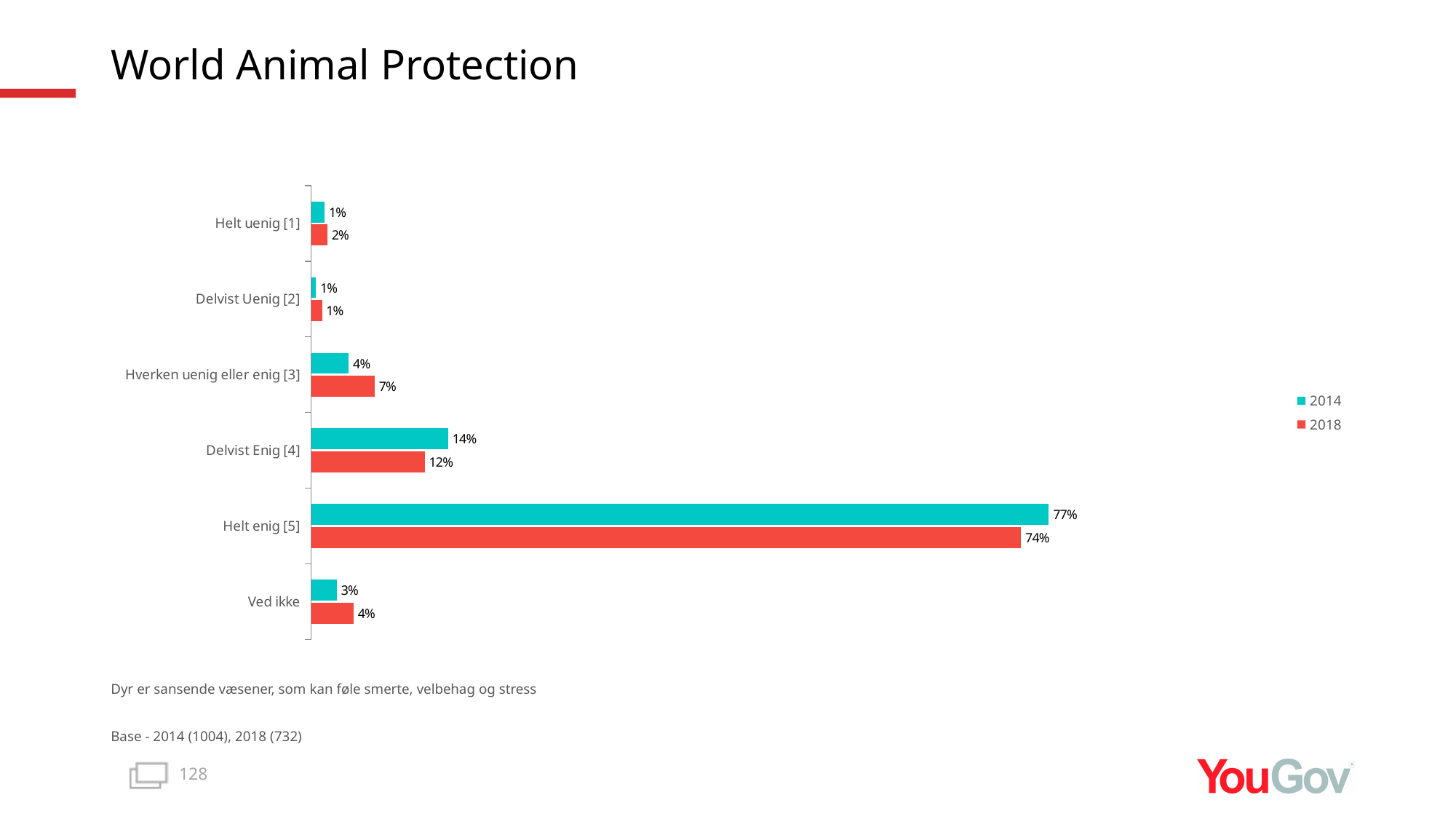
How many categories are shown on the chart? 6 How many series does the legend list? 2 For Delvist Enig [4], which year has the larger value, 2014 or 2018? 2014 Which category has the highest 2018 value? Helt enig [5] What is the 2018 value for Hverken uenig eller enig [3]? 7% For Ved ikke, which year has the larger value, 2014 or 2018? 2018 What is the 2018 value for Delvist Enig [4]? 12% What is the difference between the 2014 and 2018 values for Helt enig [5]? 3% What is the difference between the 2014 and 2018 values for Hverken uenig eller enig [3]? 3% What type of chart is shown on the slide? Bar chart What is the 2014 value for Ved ikke? 3% What is the 2014 value for Helt enig [5]? 77%